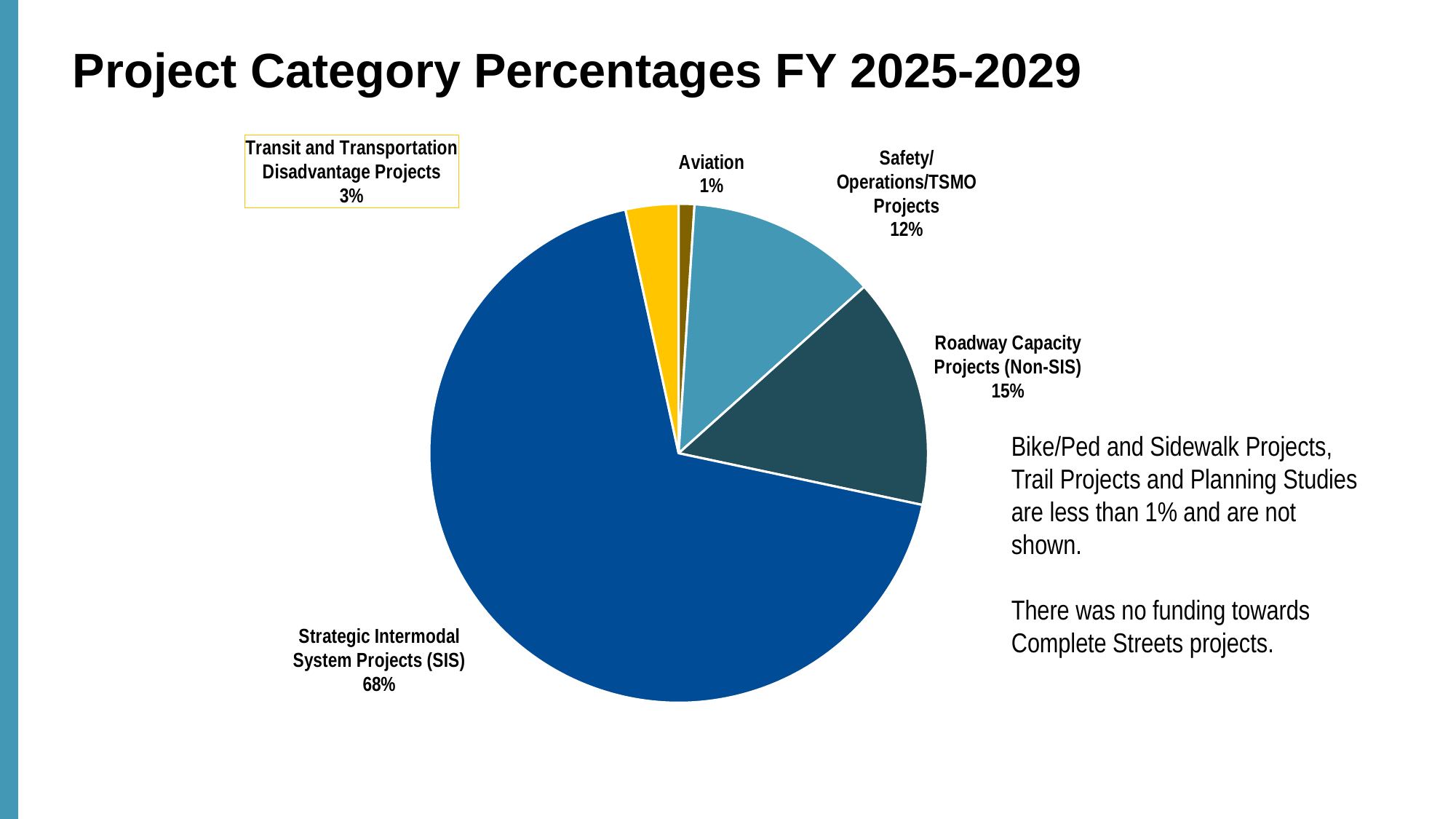
What percentage is shown for Transit and Transportation Disadvantage Projects? 3% Which category has the smallest share of the pie? Aviation What is the difference in percentage points between Roadway Capacity Projects (Non-SIS) and Safety/Operations/TSMO Projects? 3 How many slices are shown in the pie chart? 5 What kind of chart is shown on the slide? Pie chart What percentage is shown for Safety/Operations/TSMO Projects? 12% What is the title of the slide's chart? Project Category Percentages FY 2025-2029 Which is larger: the share for Safety/Operations/TSMO Projects or the share for Transit and Transportation Disadvantage Projects? Safety/Operations/TSMO Projects What percentage of the pie is Strategic Intermodal System Projects (SIS)? 68% What percentage is shown for Roadway Capacity Projects (Non-SIS)? 15% Which category has the largest share of the pie? Strategic Intermodal System Projects (SIS) What percentage is shown for Aviation? 1%